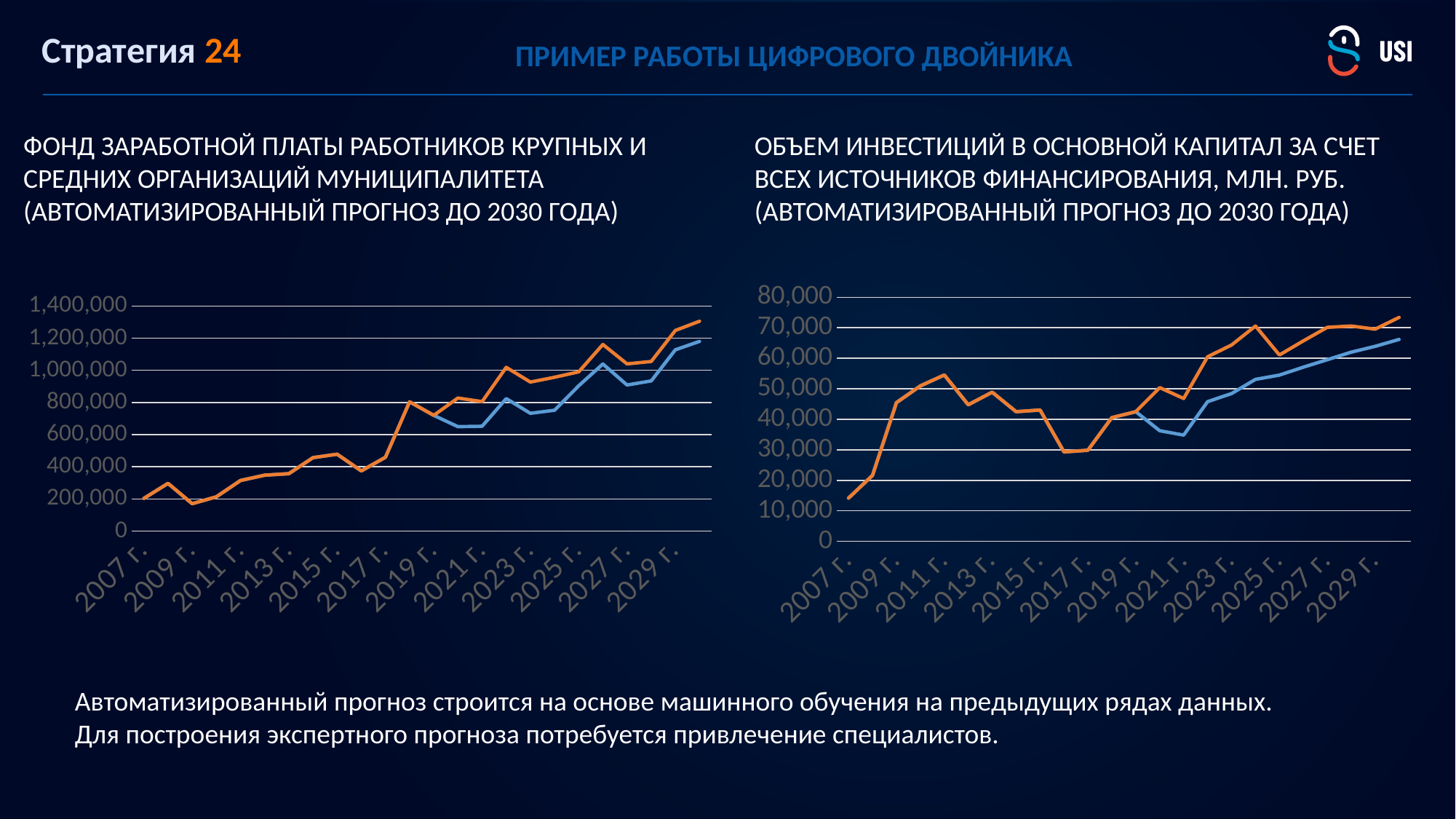
How many year labels are shown on the x axis of the left chart (Фонд заработной платы)? 12 In the right chart (Объем инвестиций в основной капитал), is the orange line's value for 2011 greater or less than 50,000? greater What is the highest value shown on the y axis of the right chart (Объем инвестиций в основной капитал)? 80,000 What kind of chart is the left chart (Фонд заработной платы)? line chart In the right chart (Объем инвестиций в основной капитал), at 2021 which line is higher, the orange or the blue? orange In the left chart (Фонд заработной платы), is the orange line's value for 2013 greater or less than 400,000? less What kind of chart is the right chart (Объем инвестиций в основной капитал)? line chart In the right chart (Объем инвестиций в основной капитал), does the orange line generally rise or fall from 2017 to 2029? rise In the right chart (Объем инвестиций в основной капитал), is the orange line's value for 2007 greater or less than 20,000? less In the left chart (Фонд заработной платы), at 2029 which line is higher, the orange or the blue? orange In the left chart (Фонд заработной платы), does the orange line generally rise or fall from 2007 to 2029? rise